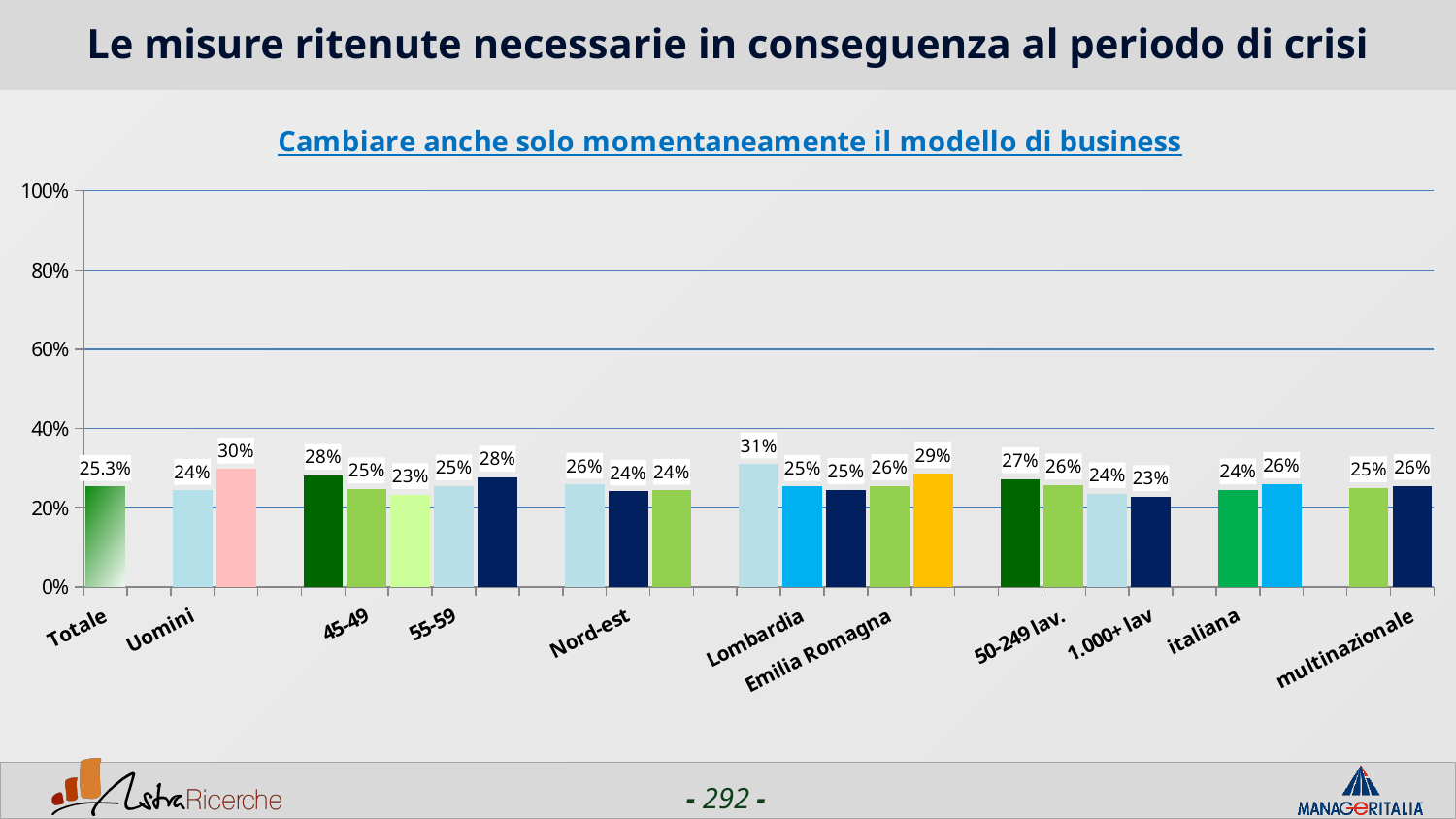
What is the subtitle shown above the chart? Cambiare anche solo momentaneamente il modello di business What is the value shown for italiana? 24% Which is larger, the value for italiana or the value for multinazionale? multinazionale What is the value shown for multinazionale? 26% What kind of chart is shown on the slide? bar chart What is the value shown for Emilia Romagna? 26% What is the value shown for Uomini? 24% What is the difference between the value for Totale and the value for Uomini? 1.3 percentage points Is the value for Totale greater or less than 40%? less What is the value shown for 1.000+ lav? 23% What is the value shown for Totale? 25.3% How many bars are plotted in the chart? 24